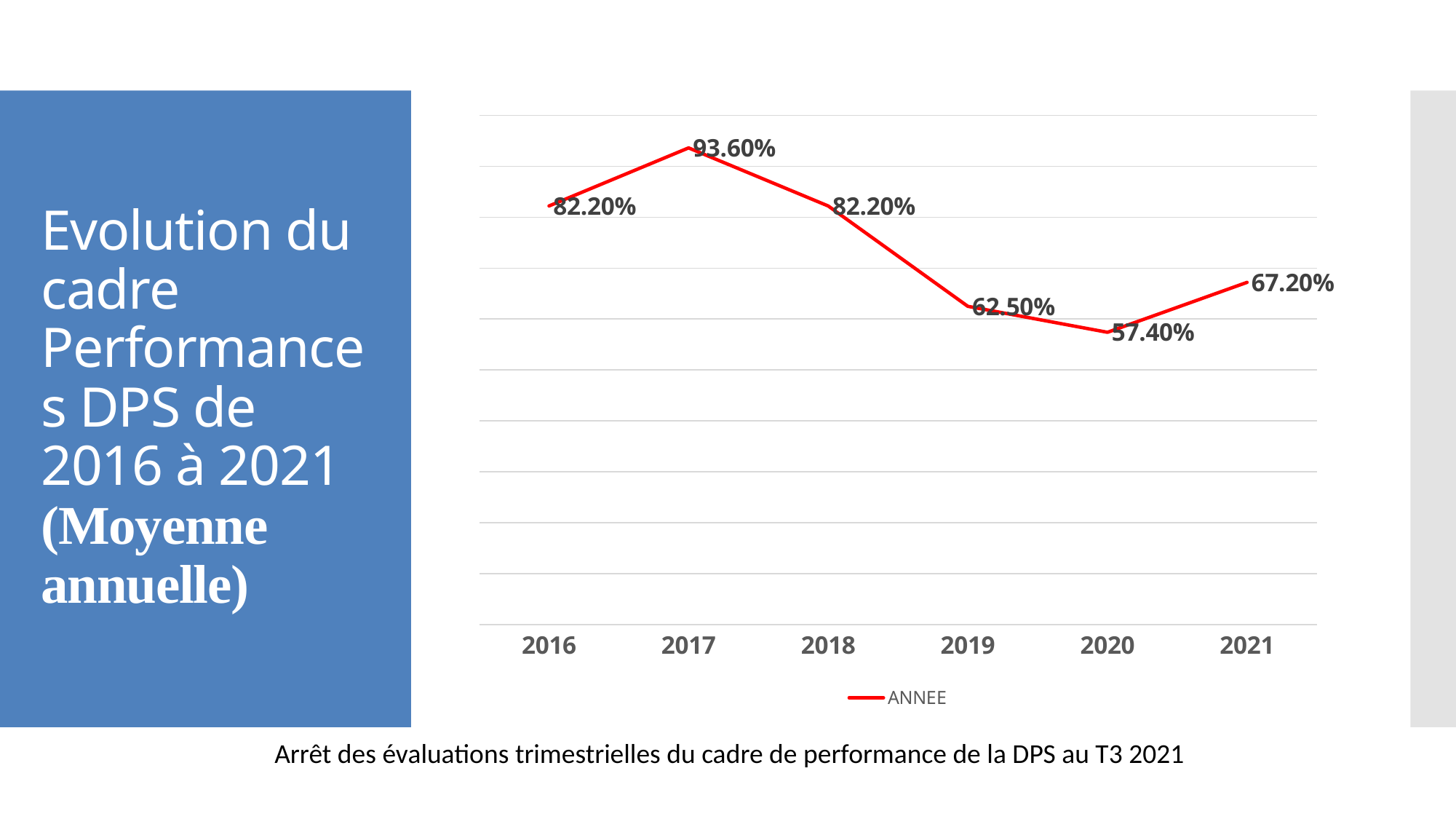
Which is larger, the value for 2019 or the value for 2021? 2021 What is the value for 2020? 57.40% Which year has the highest value? 2017 What is the value for 2019? 62.50% What is the difference between the values for 2021 and 2020? 9.80% What is the value for 2021? 67.20% What is the difference between the values for 2017 and 2018? 11.40% How many years are plotted on the x axis? 6 What is the value for 2017? 93.60% What series name does the legend show? ANNEE Which year has the lowest value? 2020 What kind of chart is shown? Line chart